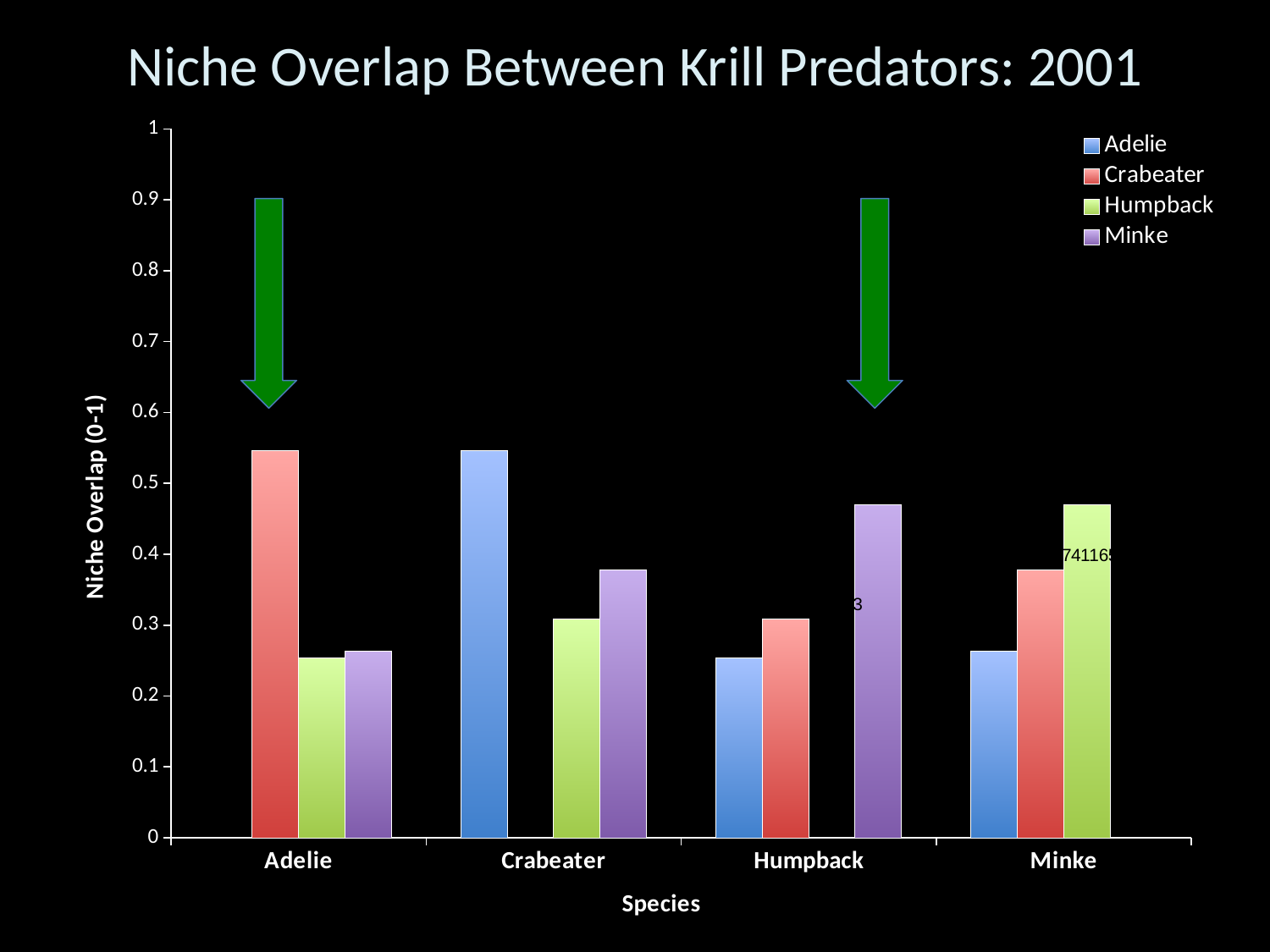
Is the Crabeater value in the Adelie category greater or less than 0.5? greater How many series does the legend list? 4 What is the title of the y axis? Niche Overlap (0-1) How many species categories are shown on the x axis? 4 In the Minke category, which is larger: the Humpback value or the Crabeater value? Humpback In the Humpback category, which series has the highest value? Minke Is the Minke value in the Humpback category greater or less than 0.4? greater What kind of chart is shown on the slide? bar chart Is the Humpback value in the Crabeater category greater or less than 0.4? less In the Crabeater category, which is larger: the Adelie value or the Minke value? Adelie In the Minke category, which series has the lowest value? Adelie